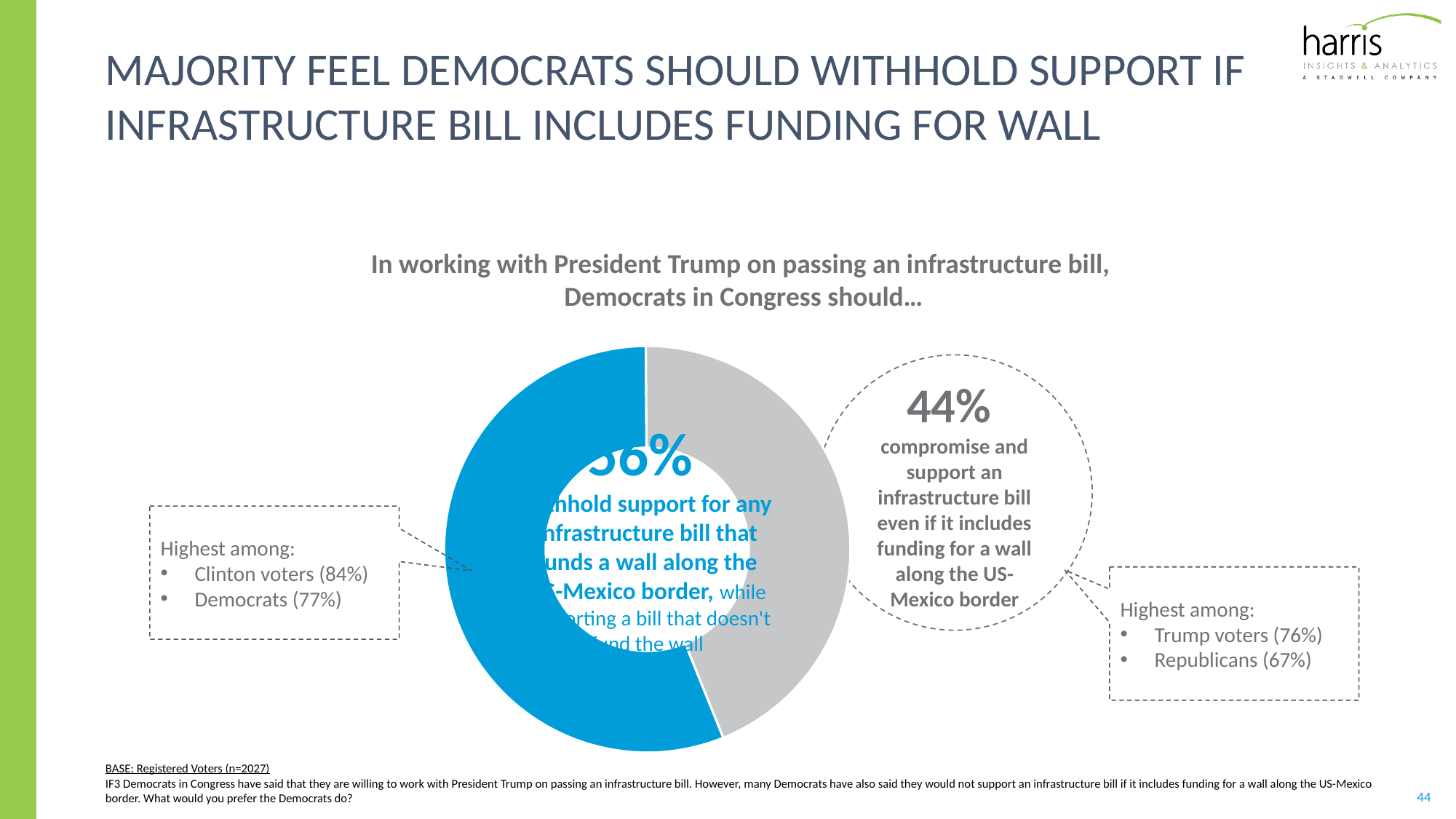
What colour is the slice representing those who say Democrats should withhold support? Blue According to the callout, what percentage of Trump voters say Democrats should compromise and support the bill? 76% Is the share for compromising and supporting the bill greater or less than 50%? less What is the title of the chart? In working with President Trump on passing an infrastructure bill, Democrats in Congress should… How many slices does the donut chart have? 2 According to the callout, what percentage of Clinton voters say Democrats should withhold support? 84% What kind of chart is shown on the slide? Pie chart (donut) What share of registered voters say Democrats should compromise and support an infrastructure bill even if it includes funding for a wall? 44% What share of registered voters say Democrats should withhold support for any infrastructure bill that funds a wall along the US-Mexico border? 56% Which option has the larger share: withholding support or compromising? Withholding support What is the difference in percentage points between the withhold-support share and the compromise share? 12 percentage points Which option has the smaller share in the donut chart? Compromise and support an infrastructure bill even if it includes funding for a wall